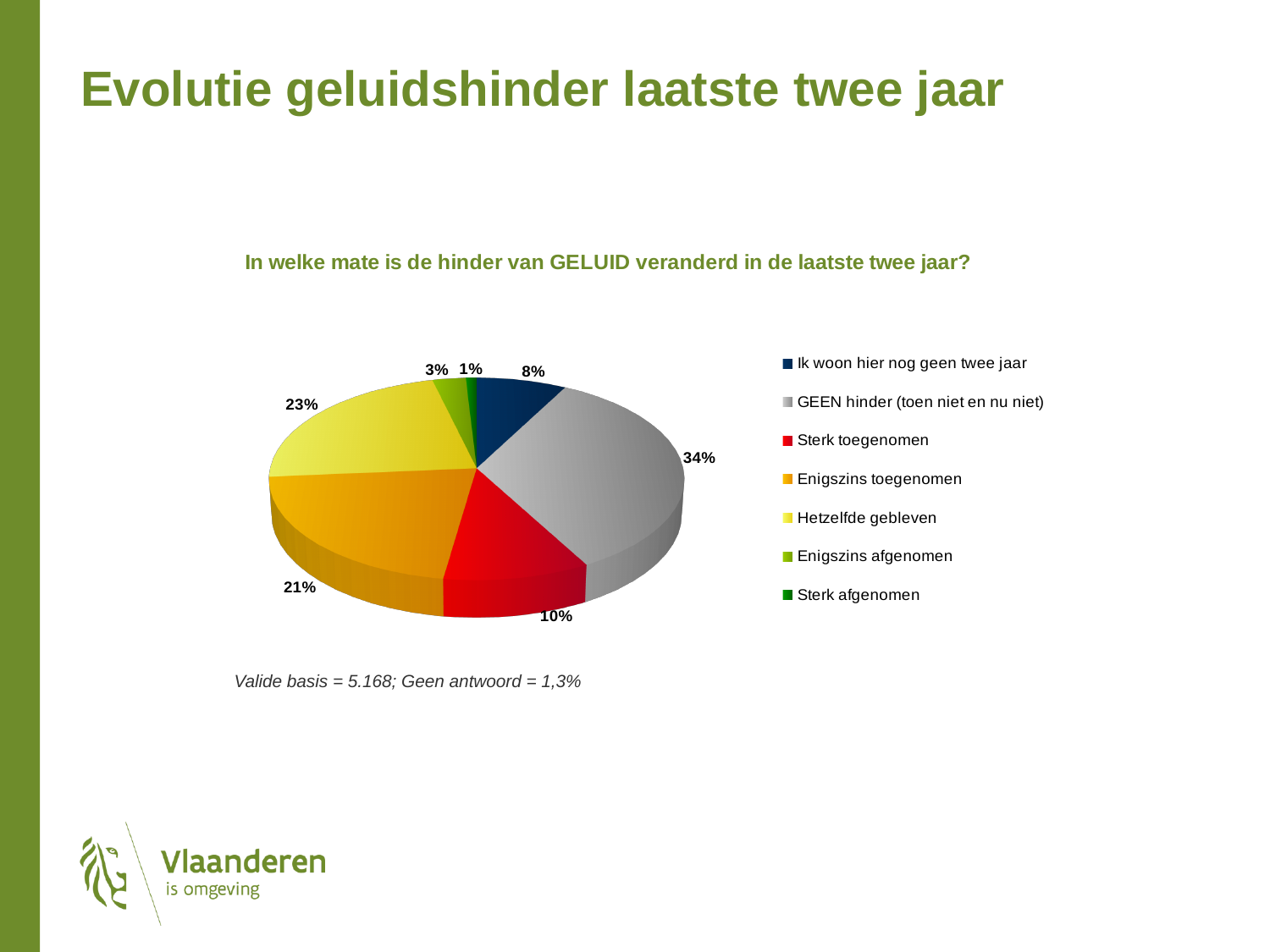
What kind of chart is shown on the slide? pie chart Which is larger: the share for 'Sterk toegenomen' or the share for 'Enigszins afgenomen'? Sterk toegenomen What percentage is shown for 'GEEN hinder (toen niet en nu niet)'? 34% Which category has the smallest share of the pie? Sterk afgenomen How many categories does the legend list? 7 What question is shown as the chart's title above the pie? In welke mate is de hinder van GELUID veranderd in de laatste twee jaar? Which category has the largest share of the pie? GEEN hinder (toen niet en nu niet) What percentage is shown for 'Hetzelfde gebleven'? 23% What percentage is shown for 'Enigszins toegenomen'? 21% What is the difference in percentage points between 'Hetzelfde gebleven' and 'Enigszins toegenomen'? 2 What percentage is shown for 'Sterk toegenomen'? 10% What percentage is shown for 'Ik woon hier nog geen twee jaar'? 8%